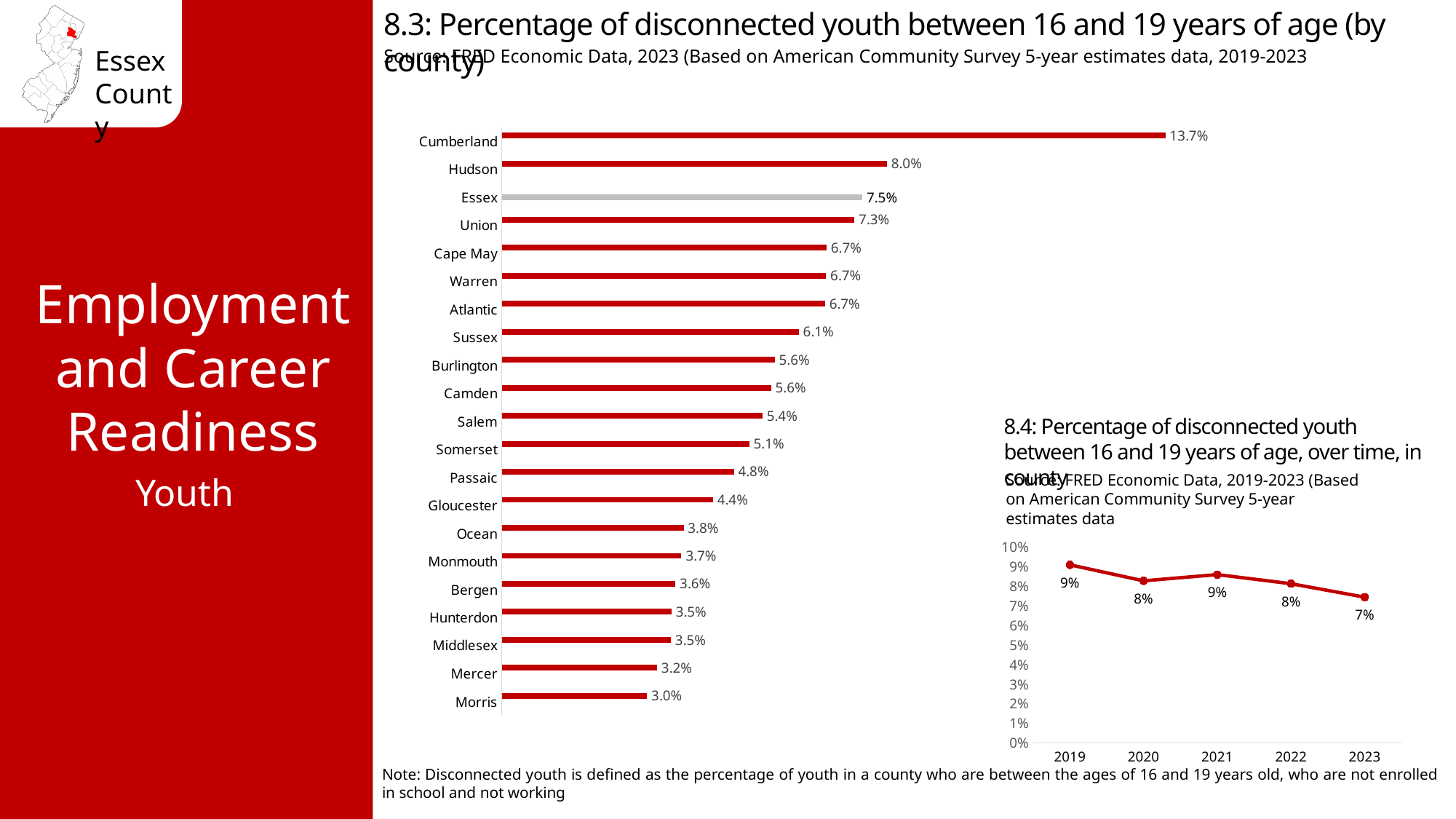
In chart 8.4 (disconnected youth over time), what is the value for 2023? 7% In chart 8.3 (by county), which county has the lowest percentage of disconnected youth? Morris In chart 8.3 (percentage of disconnected youth by county), what is the value for Essex? 7.5% In chart 8.3 (by county), what is the difference between the values for Cumberland and Hudson? 5.7% In chart 8.3 (by county), which bar is shown in a different colour (grey) from the others? Essex In chart 8.3 (by county), what is the value for Passaic? 4.8% In chart 8.3 (by county), how many counties are shown? 21 In chart 8.3 (by county), which has a higher value, Union or Sussex? Union In chart 8.3 (by county), which county has the highest percentage of disconnected youth? Cumberland What kind of chart is chart 8.3 (percentage of disconnected youth by county)? Bar chart In chart 8.4 (disconnected youth over time), how many years are plotted? 5 In chart 8.4 (disconnected youth over time), do the values generally rise or fall from 2019 to 2023? Fall